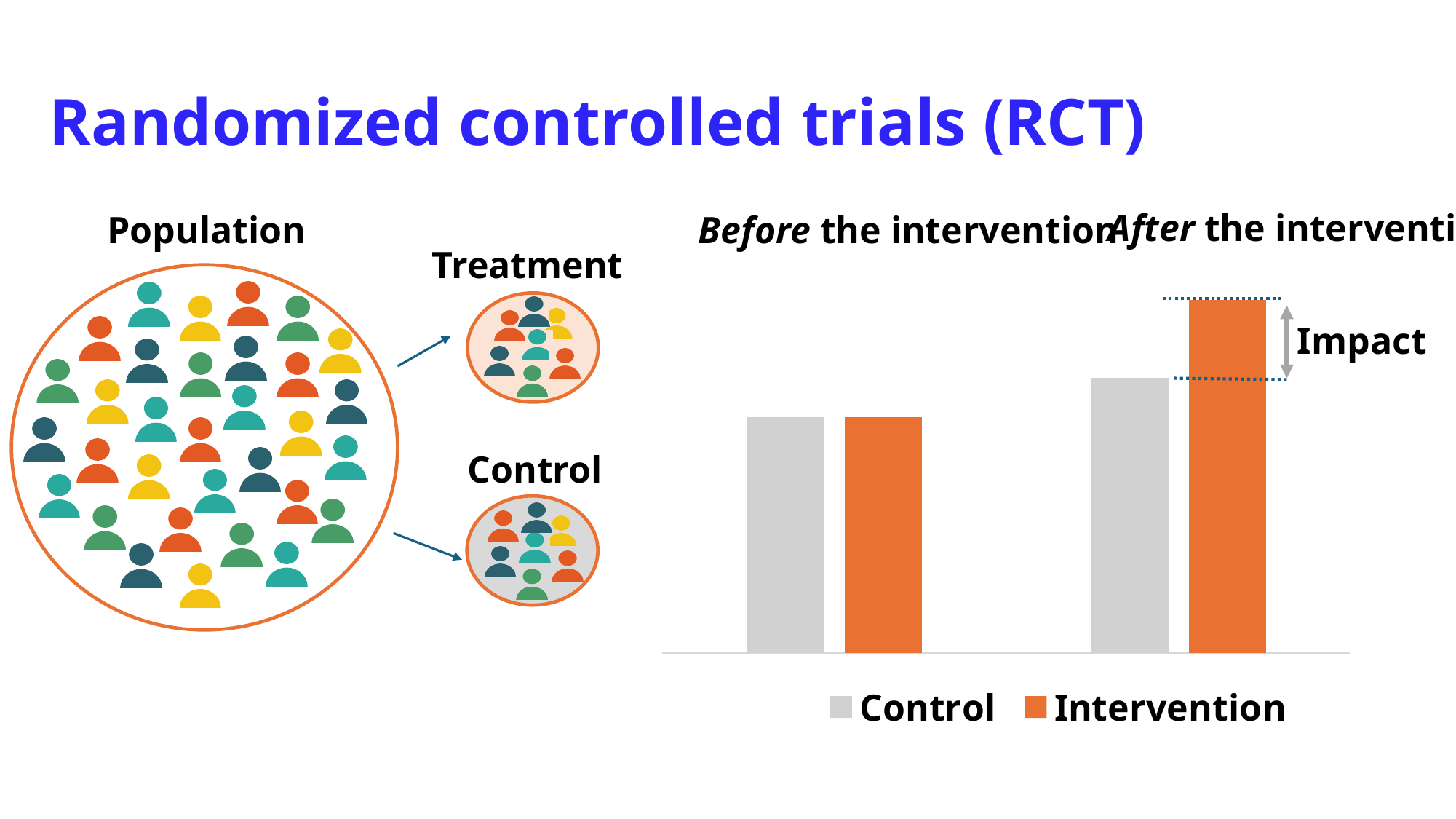
What label is attached to the gap between the Control and Intervention bars after the intervention? Impact Does the Control series rise or fall from before the intervention to after the intervention? rise What kind of chart is shown on the right side of the slide? bar chart In the bar chart, after the intervention, which is larger: the Control bar or the Intervention bar? Intervention What colour represents the Intervention series in the bar chart? orange What are the two series named in the legend of the bar chart? Control and Intervention Does the Intervention series rise or fall from before the intervention to after the intervention? rise Which bar in the bar chart is the tallest? Intervention, after the intervention How many series does the legend of the bar chart list? 2 How many category groups (time points) are shown in the bar chart? 2